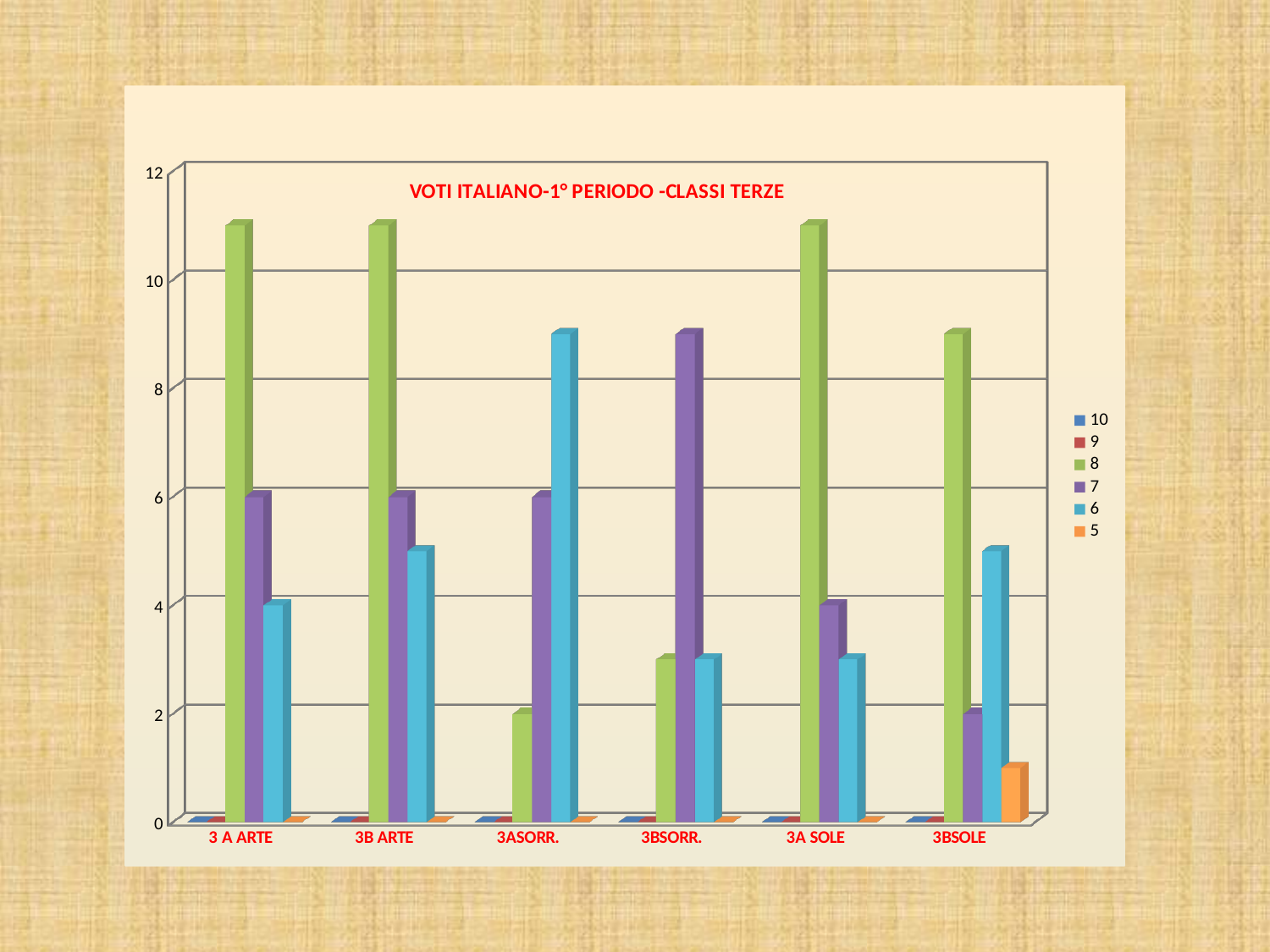
Is the value of series 5 for 3BSOLE greater or less than 2? less Is the value of series 8 for 3ASORR. greater or less than 4? less For 3ASORR., which is larger: the value of series 6 or the value of series 8? series 6 Which category has the highest value for series 6? 3ASORR. What is the title of the chart? VOTI ITALIANO-1° PERIODO -CLASSI TERZE How many series does the legend list? 6 How many categories are shown on the x axis? 6 Which category has the lowest value for series 8? 3ASORR. What kind of chart is shown on the slide? bar chart Which is larger: the value of series 7 for 3BSORR. or the value of series 7 for 3A SOLE? 3BSORR. Is the value of series 8 for 3 A ARTE greater or less than 10? greater